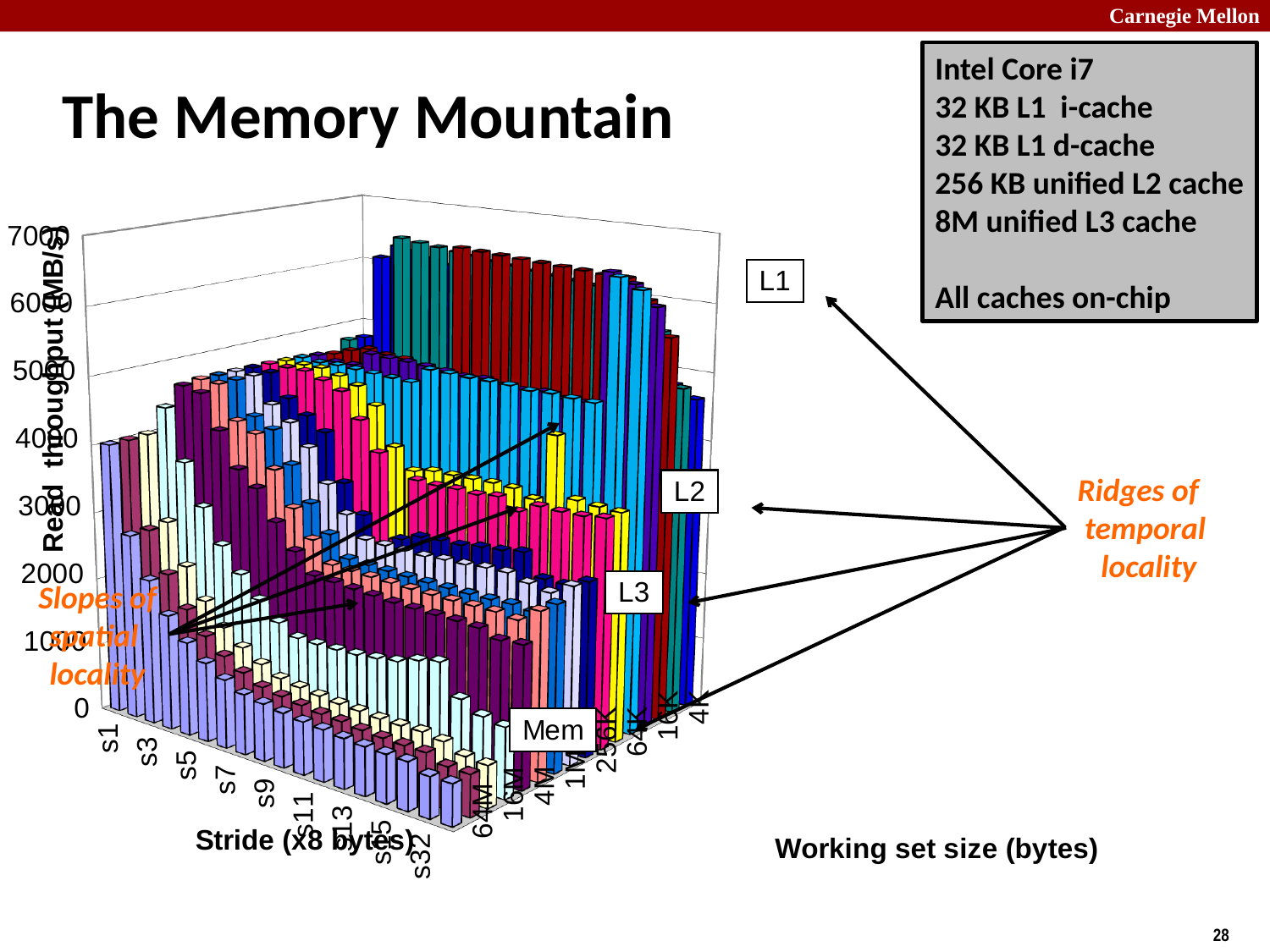
Is the read throughput for stride s1 at a working set size of 64M greater or less than 1000? greater How many stride labels are shown along the stride axis of the chart? 9 How many working set size labels are shown along the working set size axis? 8 What quantity is plotted on the vertical axis of the chart? Read throughput (MB/s) For a working set size of 64M, does read throughput rise or fall as the stride increases from s1 to s32? fall Which has the higher read throughput at a working set size of 64M: stride s1 or stride s32? s1 Which has the higher read throughput at stride s1: a working set size of 4K or 64M? 4K What kind of chart is shown on the slide? 3D bar chart Is the read throughput for stride s32 at a working set size of 64M greater or less than 3000? less What is the title of the chart on the slide? The Memory Mountain